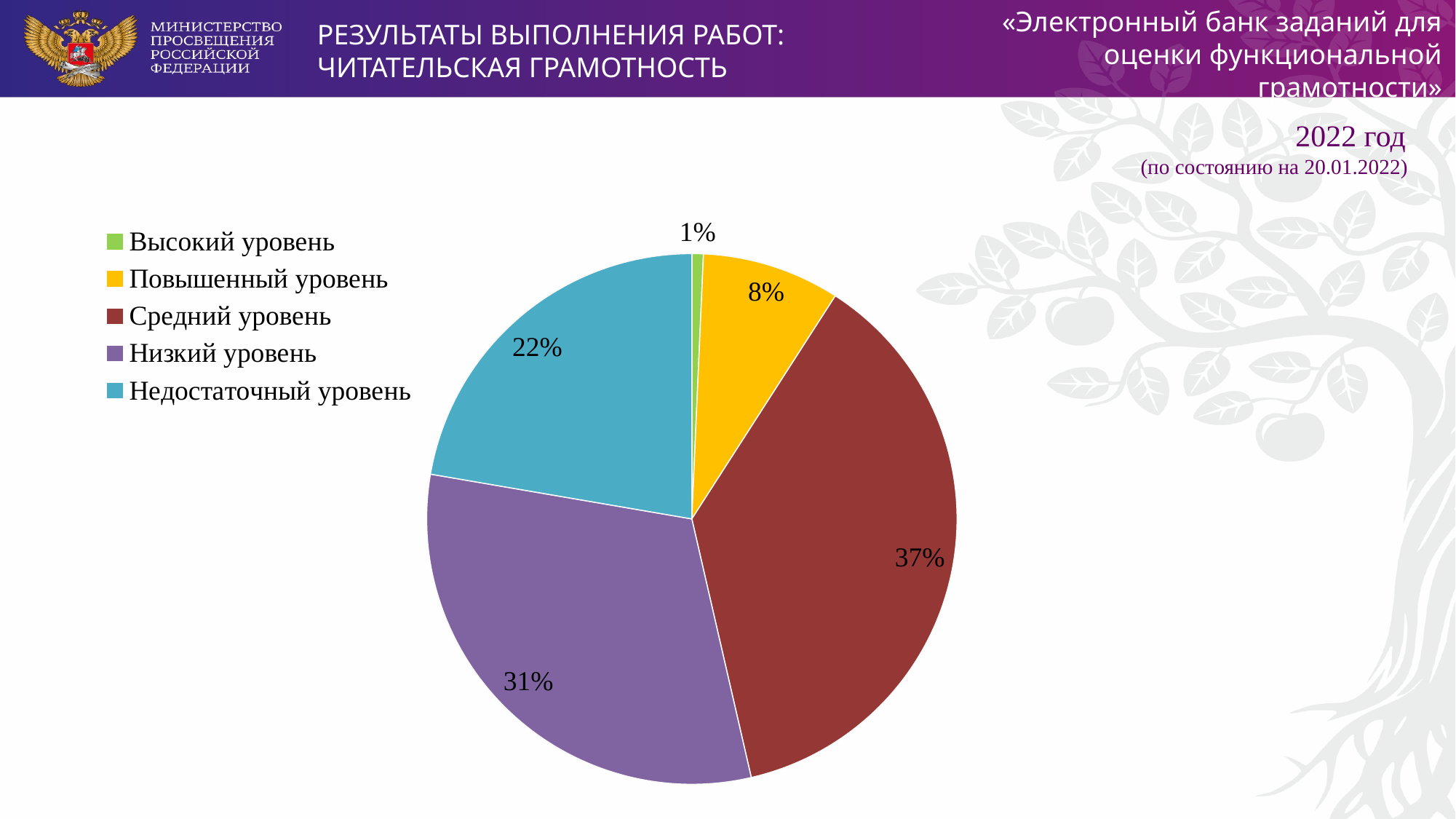
What share of the pie does Недостаточный уровень have? 22% What share of the pie does Повышенный уровень have? 8% What share of the pie does Высокий уровень have? 1% What kind of chart is shown on the slide? pie chart How many categories does the legend list? 5 Which is larger: the share for Недостаточный уровень or the share for Повышенный уровень? Недостаточный уровень What is the difference in percentage points between Средний уровень and Низкий уровень? 6 Which level has the smallest slice of the pie? Высокий уровень Which level has the largest slice of the pie? Средний уровень What colour is the slice for Низкий уровень? purple